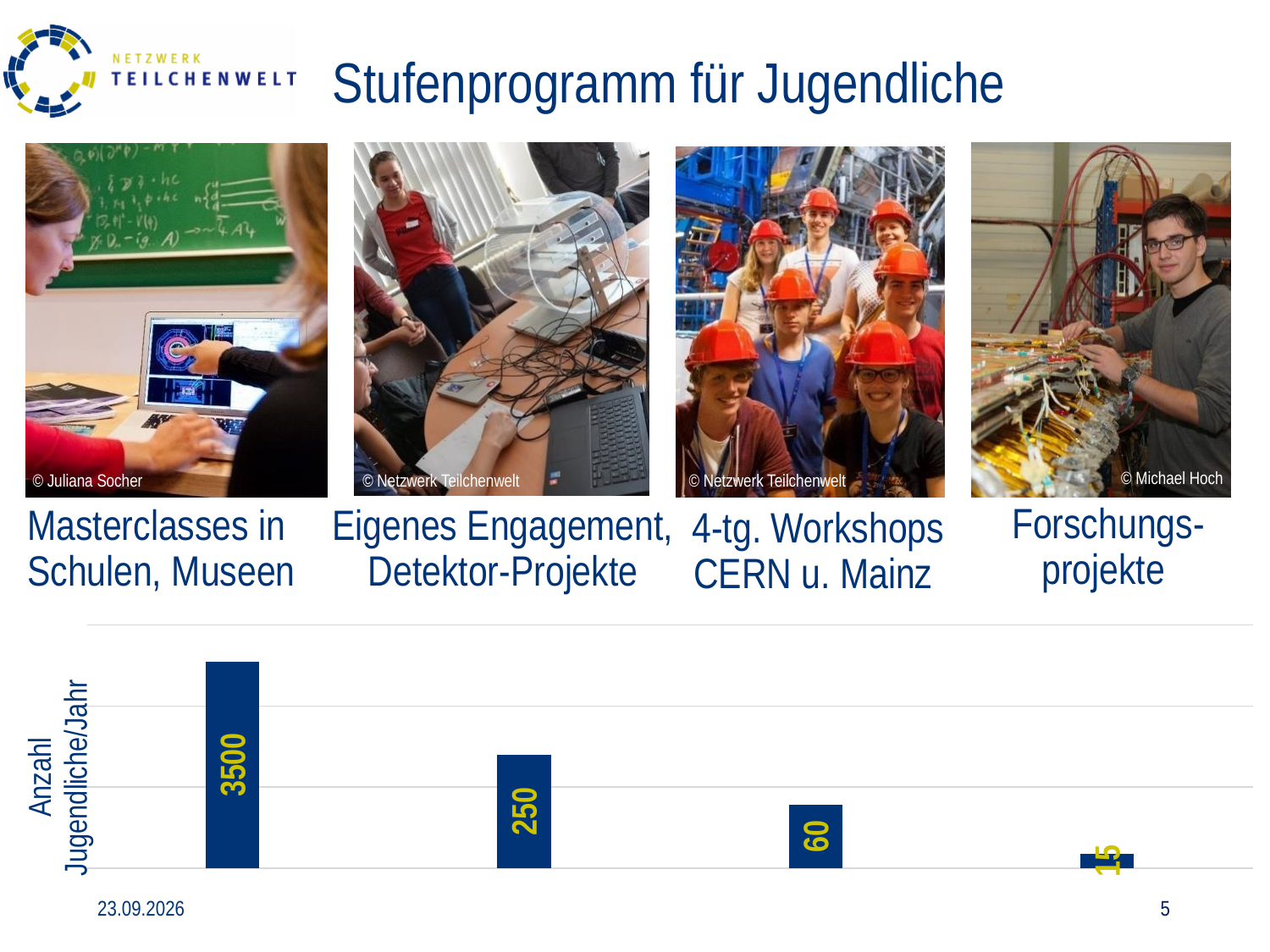
Which category has the highest value? Masterclasses in Schulen, Museen Which is larger, the value for Eigenes Engagement, Detektor-Projekte or the value for 4-tg. Workshops CERN u. Mainz? Eigenes Engagement, Detektor-Projekte What is the difference between the values for 4-tg. Workshops CERN u. Mainz and Forschungsprojekte? 45 Which category has the lowest value? Forschungsprojekte How many bars are shown in the chart? 4 What kind of chart is shown on the slide? Bar chart What is the value for Masterclasses in Schulen, Museen? 3500 What is the value for Eigenes Engagement, Detektor-Projekte? 250 What is the value for Forschungsprojekte? 15 Do the values rise or fall from left to right across the chart? Fall What is the value for 4-tg. Workshops CERN u. Mainz? 60 What is the difference between the values for Masterclasses in Schulen, Museen and Eigenes Engagement, Detektor-Projekte? 3250